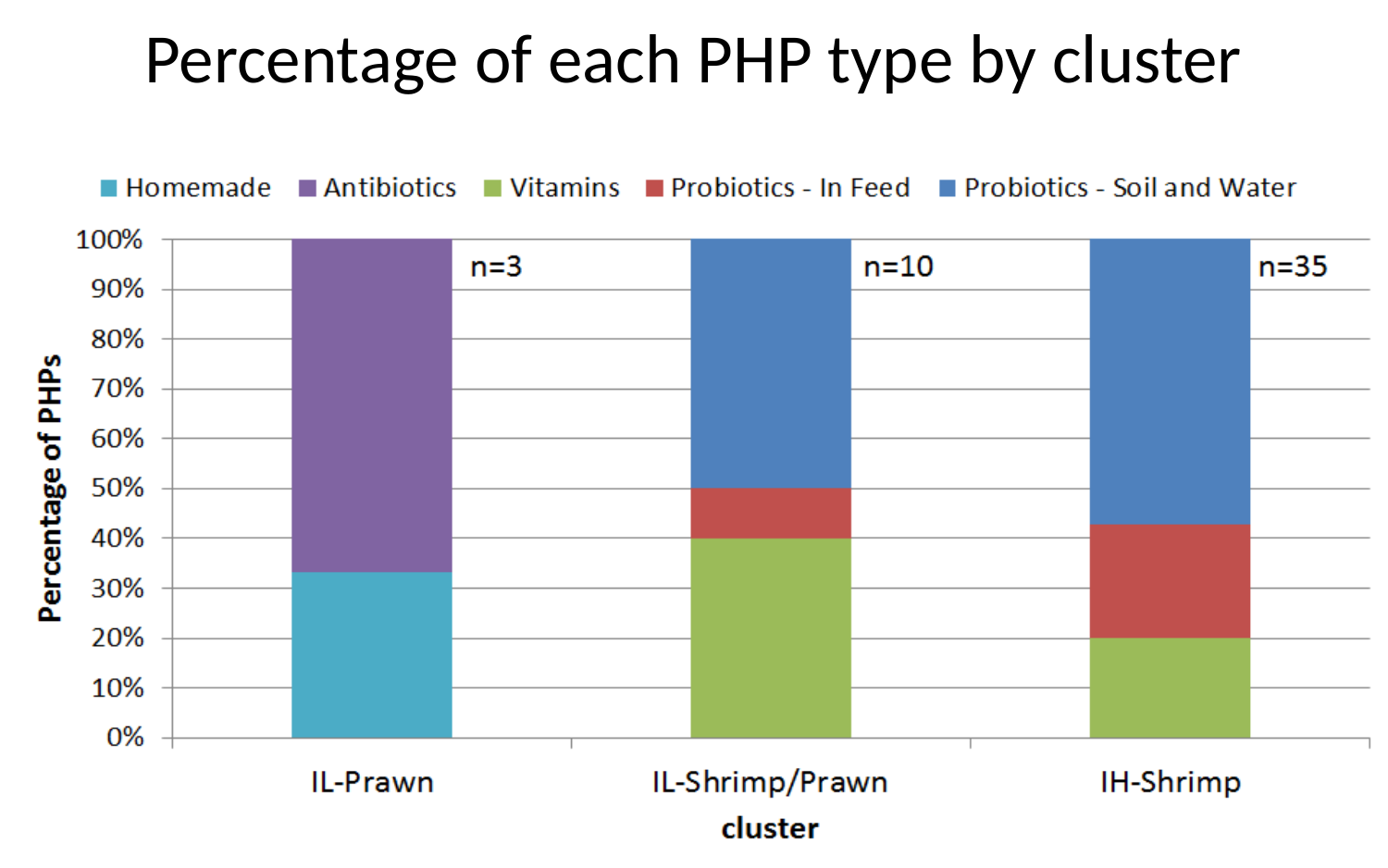
Is the Antibiotics value for IL-Prawn greater or less than 60%? greater What is the n value printed next to the IL-Prawn bar? n=3 Is the Probiotics - Soil and Water value for IH-Shrimp greater or less than 50%? greater Is the Homemade value for IL-Prawn greater or less than 40%? less How many series does the legend list? 5 What is the total height of the stacked bar for IL-Prawn? 100% What is the n value printed next to the IH-Shrimp bar? n=35 How many clusters are shown on the x axis? 3 What kind of chart is shown on the slide? bar chart What is the title of the chart? Percentage of each PHP type by cluster Which cluster has the larger Probiotics - In Feed share, IL-Shrimp/Prawn or IH-Shrimp? IH-Shrimp Which cluster has the larger Vitamins share, IL-Shrimp/Prawn or IH-Shrimp? IL-Shrimp/Prawn